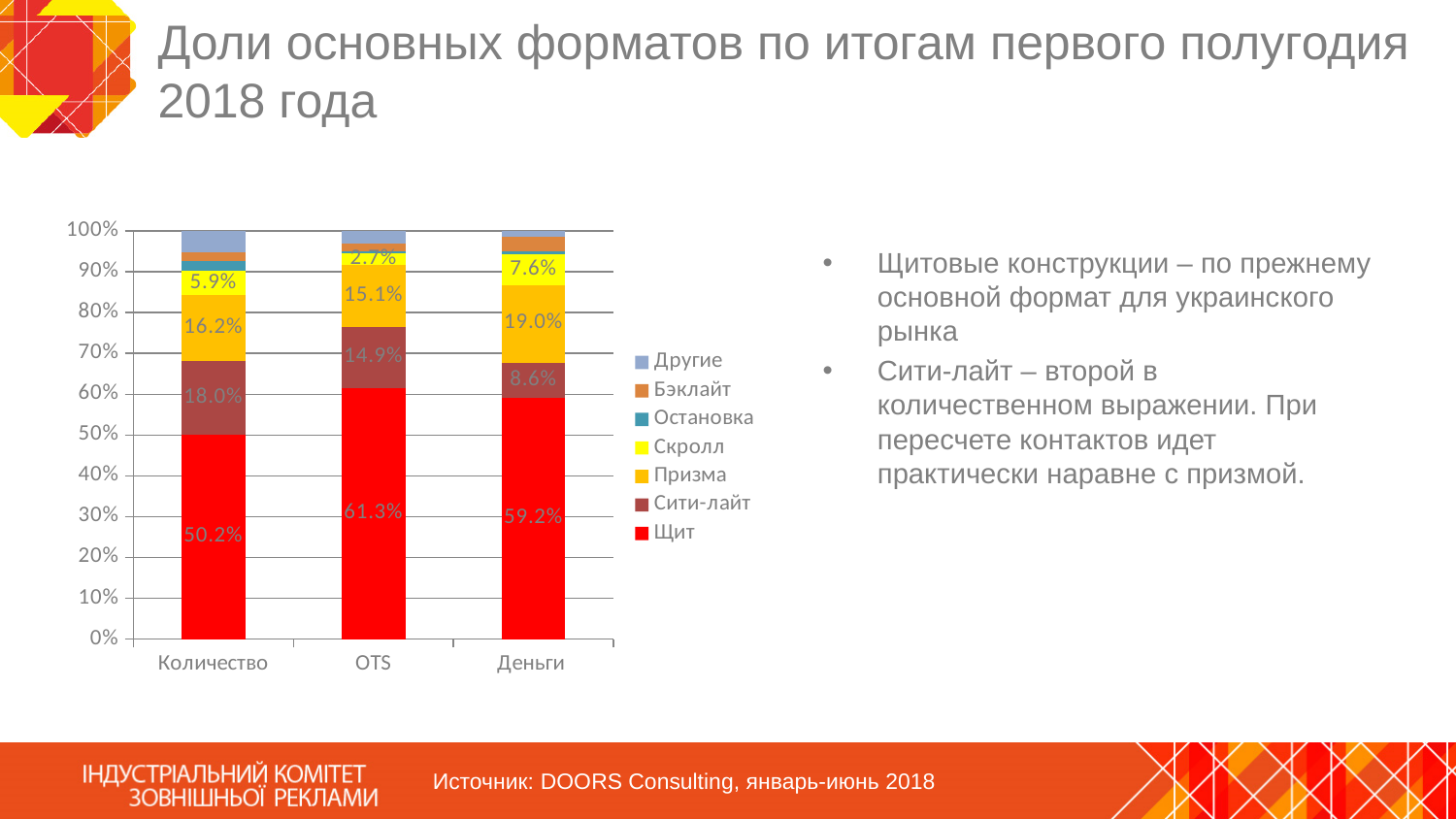
Which legend entry is shown in red? Щит What kind of chart is shown on the slide? Stacked bar chart In which category does Щит have its largest share? OTS How many series does the legend list? 7 What is the difference between the Щит share in OTS and in Количество? 11.1% What share does Щит have in the Количество bar? 50.2% In which category does Сити-лайт have its smallest share? Деньги What share does Призма have in the Деньги bar? 19.0% What share does Скролл have in the OTS bar? 2.7% How many categories are shown on the x axis? 3 Which is larger in the Деньги bar: the Призма share or the Сити-лайт share? Призма What share does Сити-лайт have in the OTS bar? 14.9%